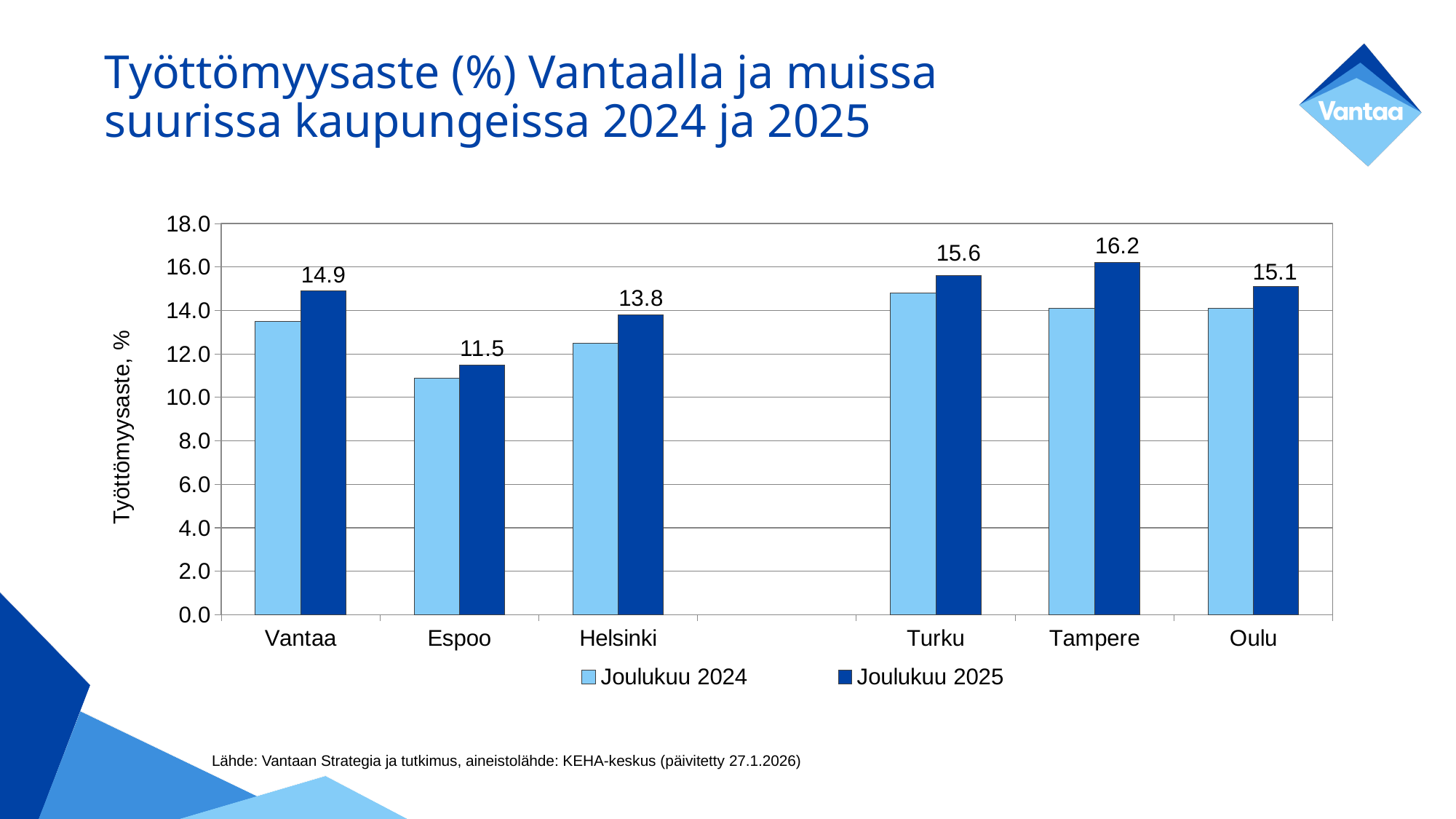
Which city has the highest unemployment rate in Joulukuu 2025? Tampere What is the unemployment rate for Espoo in Joulukuu 2025? 11.5 How many cities are shown on the x axis of the chart? 6 What is the unemployment rate for Tampere in Joulukuu 2025? 16.2 Is the Joulukuu 2024 unemployment rate for Vantaa greater or less than 14.0? less What kind of chart is shown on the slide? Bar chart Is the Joulukuu 2024 unemployment rate for Espoo greater or less than 10.0? greater Which is larger in Joulukuu 2025: the unemployment rate of Turku or Oulu? Turku Which city has the lowest unemployment rate in Joulukuu 2025? Espoo What is the unemployment rate for Vantaa in Joulukuu 2025? 14.9 What is the difference between the Joulukuu 2025 unemployment rates of Tampere and Espoo? 4.7 How many series does the legend list? 2